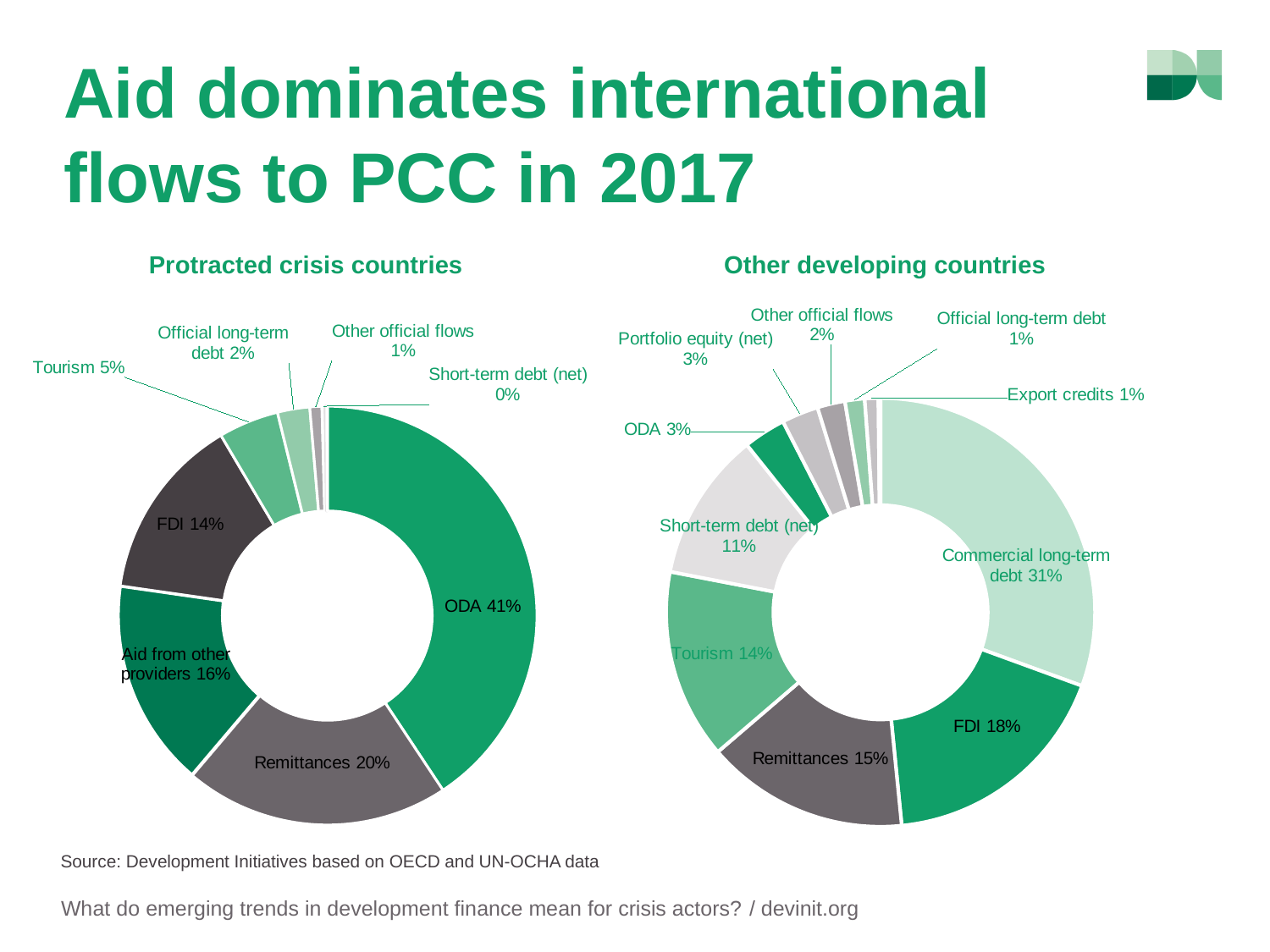
How many categories are shown in the 'Other developing countries' chart? 10 In the 'Other developing countries' chart, what share does commercial long-term debt account for? 31% How many categories are shown in the 'Protracted crisis countries' chart? 8 Which is larger: the share of Tourism in the 'Protracted crisis countries' chart or in the 'Other developing countries' chart? Other developing countries In the 'Protracted crisis countries' chart, what is the difference between the shares for Remittances and FDI? 6 percentage points In the 'Protracted crisis countries' chart, what share does ODA account for? 41% In the 'Other developing countries' chart, what is the difference between the shares for FDI and Remittances? 3 percentage points In the 'Other developing countries' chart, which category has the largest share? Commercial long-term debt In the 'Protracted crisis countries' chart, which category has the smallest share? Short-term debt (net) What type of chart is used on this slide? Pie (donut) chart In the 'Protracted crisis countries' chart, is the share for Remittances larger than the share for Aid from other providers? Yes In the 'Protracted crisis countries' chart, which category has the largest share? ODA